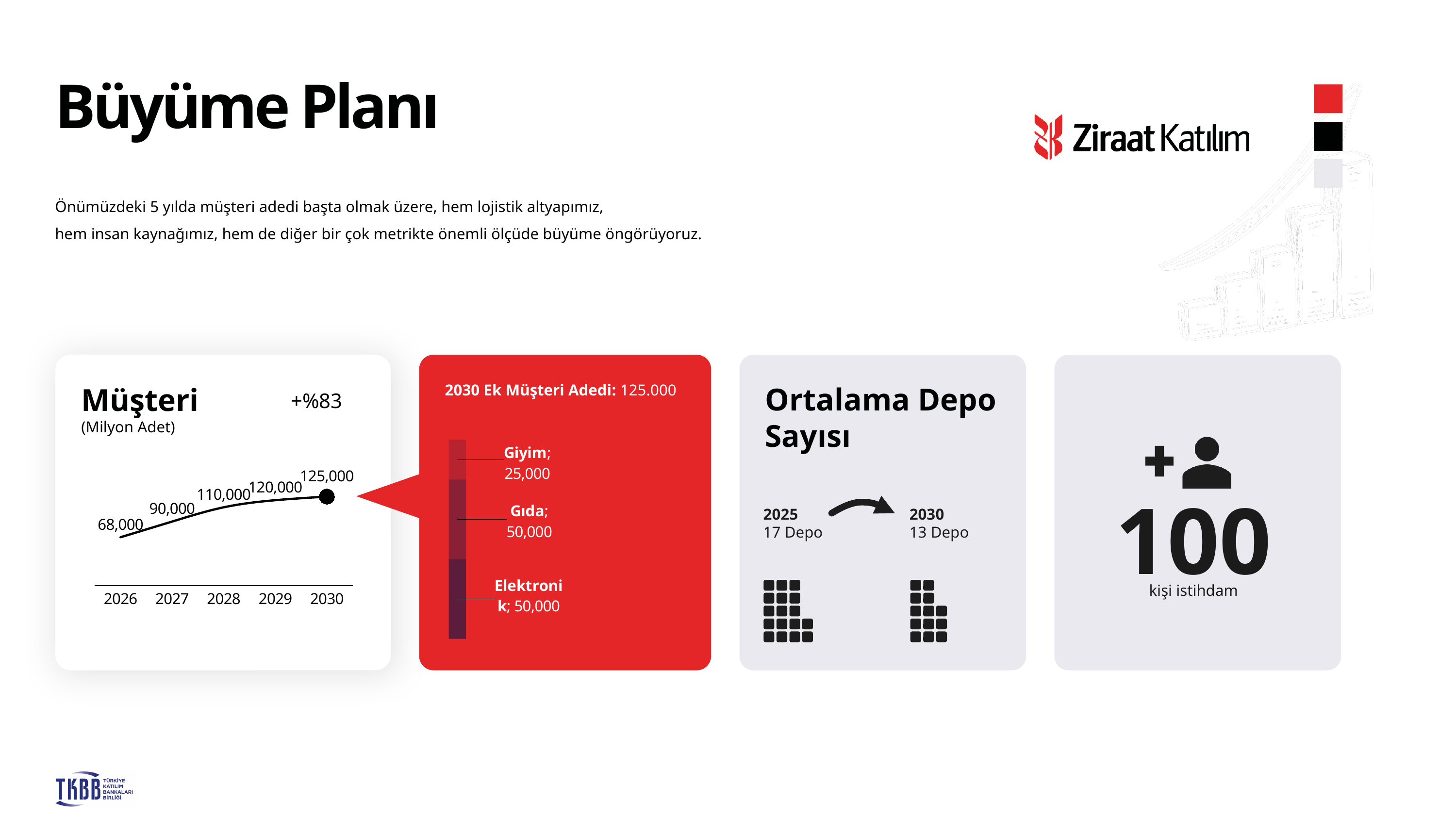
In the Müşteri line chart, do the values rise or fall from 2026 to 2030? rise What kind of chart is the Müşteri chart? line chart In the stacked bar chart in the red box, what is the value for Gıda? 50,000 In the Müşteri line chart, which year has the highest value? 2030 In the Müşteri line chart, what is the value for 2026? 68,000 In the stacked bar chart in the red box, which segment is the smallest? Giyim In the Müşteri line chart, which year has the lowest value? 2026 In the Müşteri line chart, how many years are plotted on the x axis? 5 In the Müşteri line chart, what is the value for 2028? 110,000 In the Müşteri line chart, what is the value for 2030? 125,000 In the Müşteri line chart, what is the difference between the 2027 and 2026 values? 22,000 In the stacked bar chart in the red box, what is the total of the three segments? 125,000